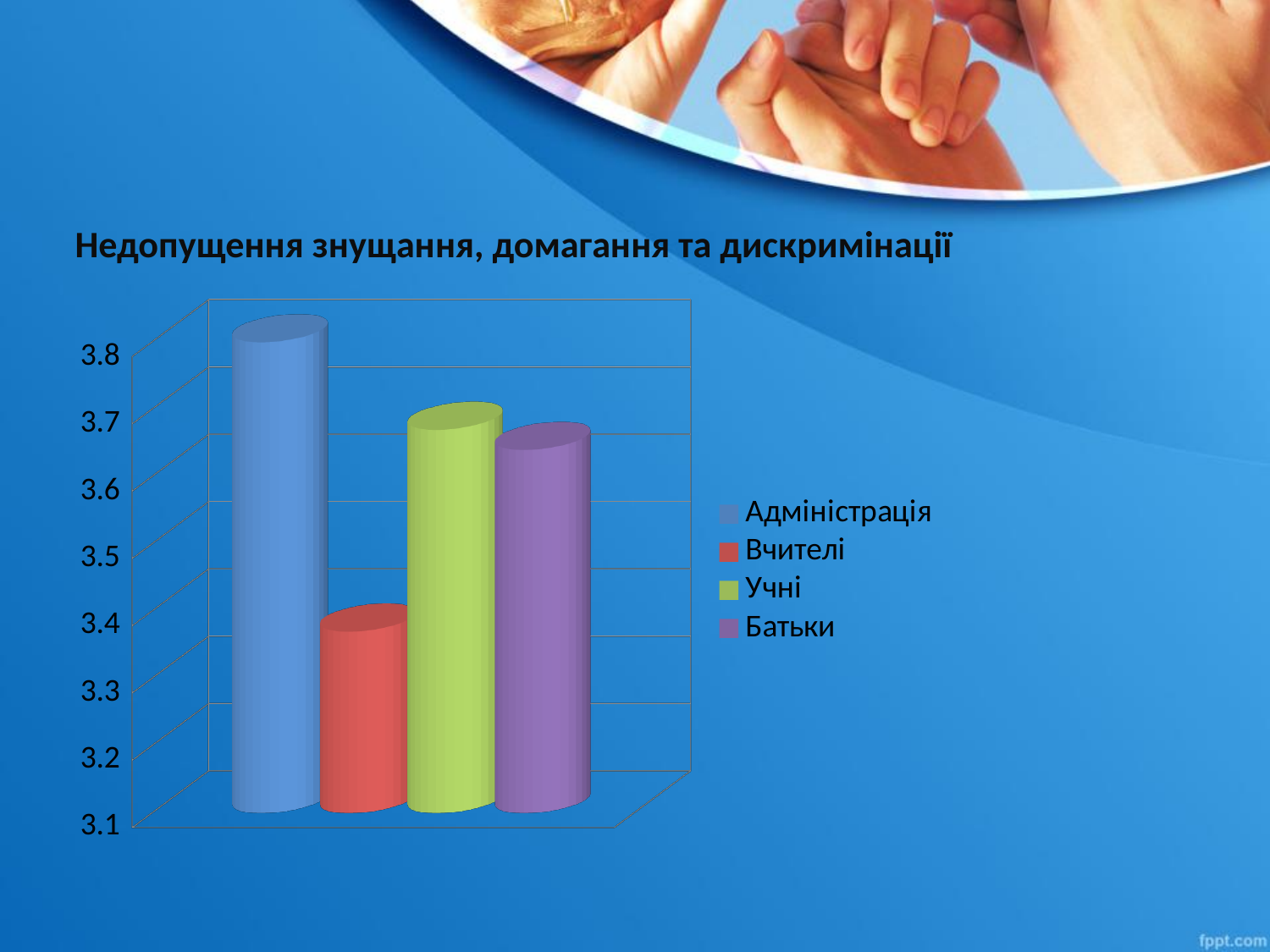
What colour is the bar for Учні? green Is the value for Учні greater or less than 3.6? greater How many bars are plotted in the chart? 4 Is the value for Адміністрація greater or less than 3.7? greater Is the value for Батьки greater or less than 3.5? greater Which series has the highest value? Адміністрація How many series does the legend list? 4 Which is larger, the value for Вчителі or the value for Батьки? Батьки Which series has the lowest value? Вчителі What kind of chart is shown on the slide? bar chart What is the title of the chart? Недопущення знущання, домагання та дискримінації